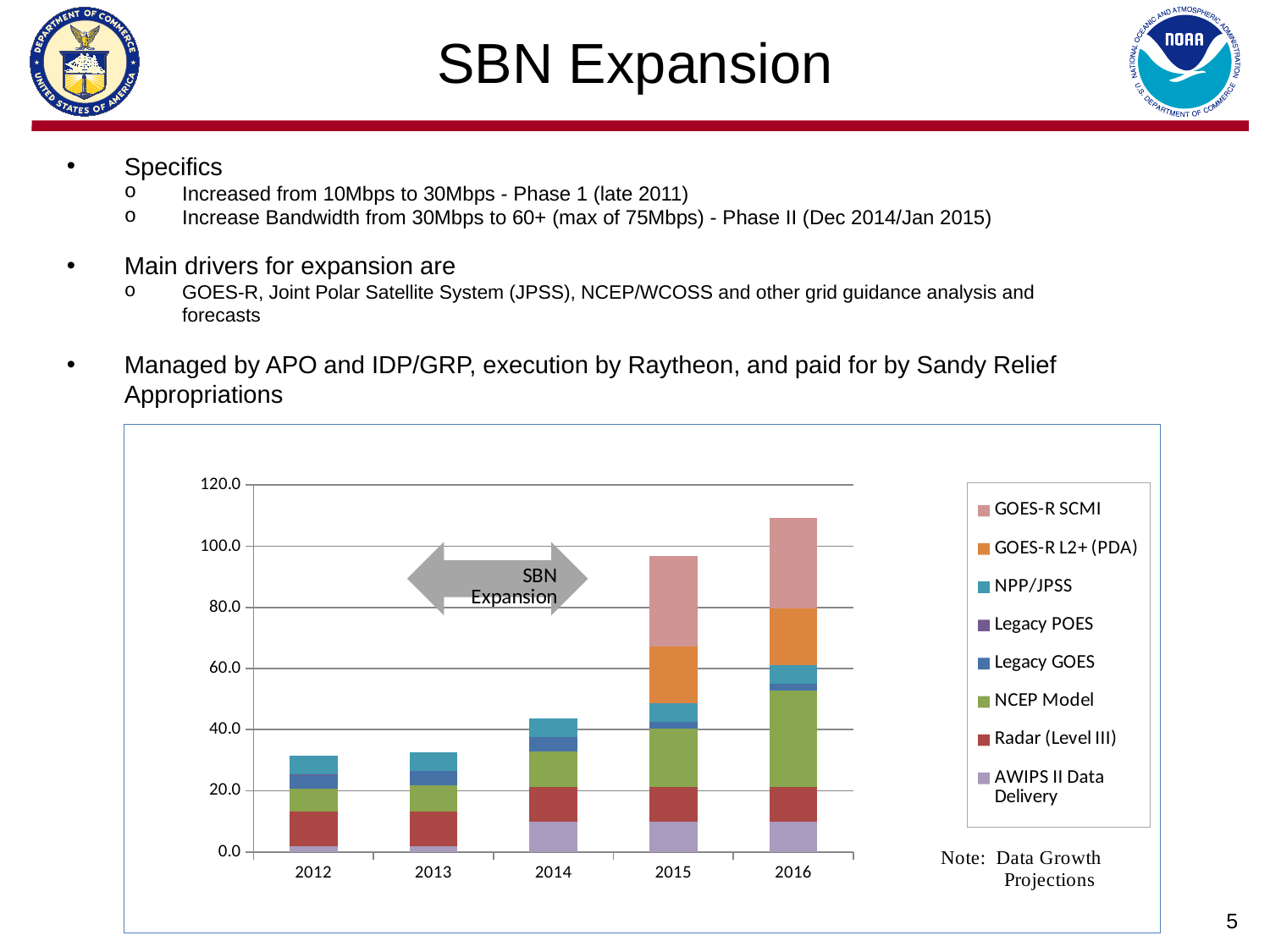
How many series does the chart's legend list? 8 How many years are shown along the x axis of the chart? 5 Is the total stacked bar for 2015 greater or less than 80.0? greater Is the total stacked bar for 2014 greater or less than 60.0? less What text is written inside the double-headed arrow annotation on the chart? SBN Expansion Is the total stacked bar for 2012 greater or less than 40.0? less Which year has the tallest stacked bar? 2016 Do the stacked bar totals rise or fall from 2012 to 2016? rise Which series appears at the top of the stacked bars for 2015 and 2016? GOES-R SCMI Which year has the larger stacked bar total, 2014 or 2015? 2015 What kind of chart is shown on the slide? stacked bar chart